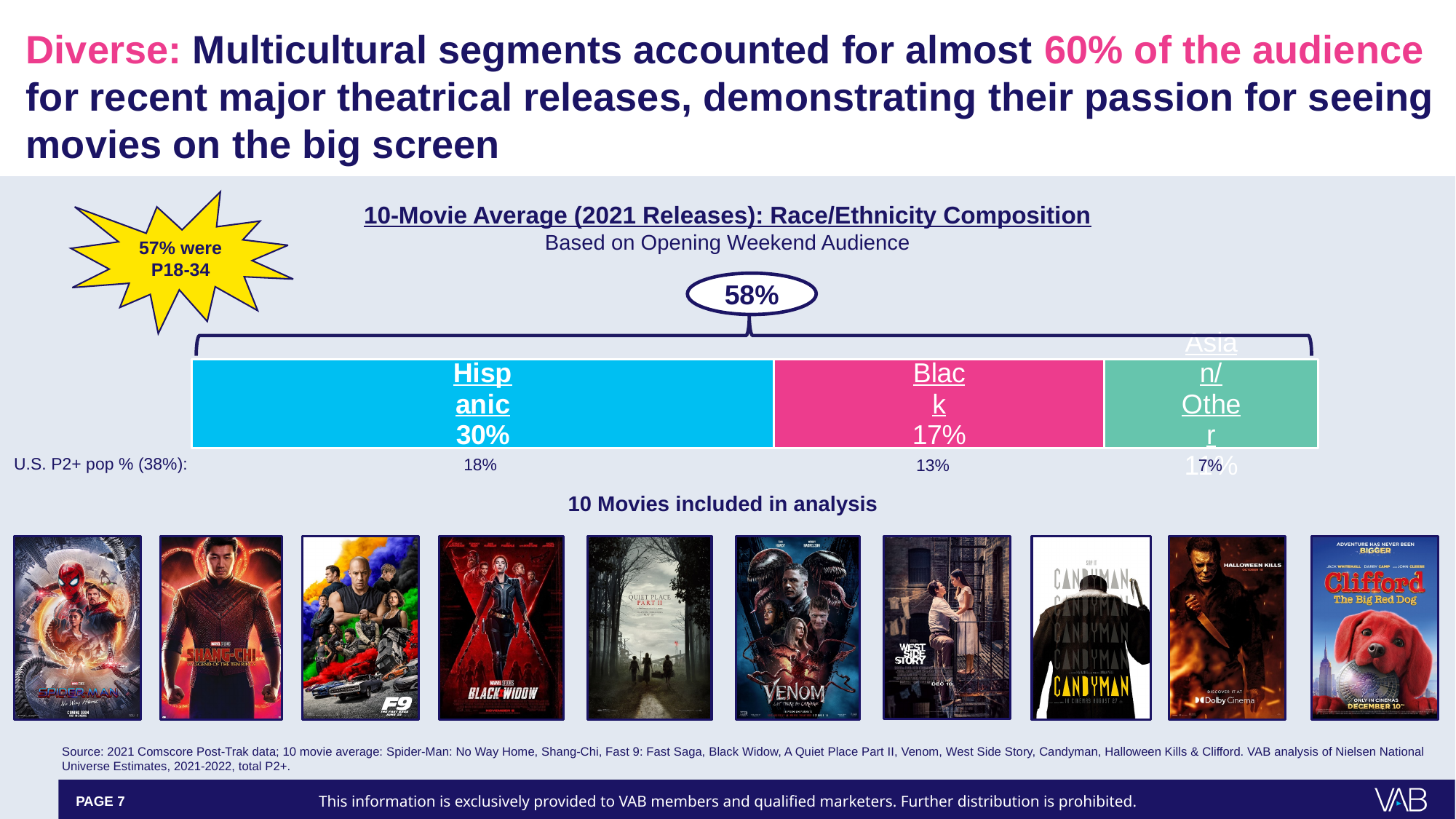
Which segment of the bar is the smallest? Asian/Other What is the combined total of the multicultural segments shown above the bar? 58% What kind of chart is used to show the race/ethnicity composition? Stacked bar chart What is the U.S. P2+ population percentage shown for Hispanic? 18% Which segment of the bar is the largest? Hispanic What share of the opening weekend audience is Hispanic in the 10-movie average? 30% What is the U.S. P2+ population percentage shown for Black? 13% How many percentage points larger is the Hispanic segment than the Black segment? 13 percentage points How many race/ethnicity segments are shown in the bar? 3 What share of the opening weekend audience is Black in the 10-movie average? 17% What is the title of the chart on the slide? 10-Movie Average (2021 Releases): Race/Ethnicity Composition Which is larger, the Hispanic segment or the Black segment? Hispanic